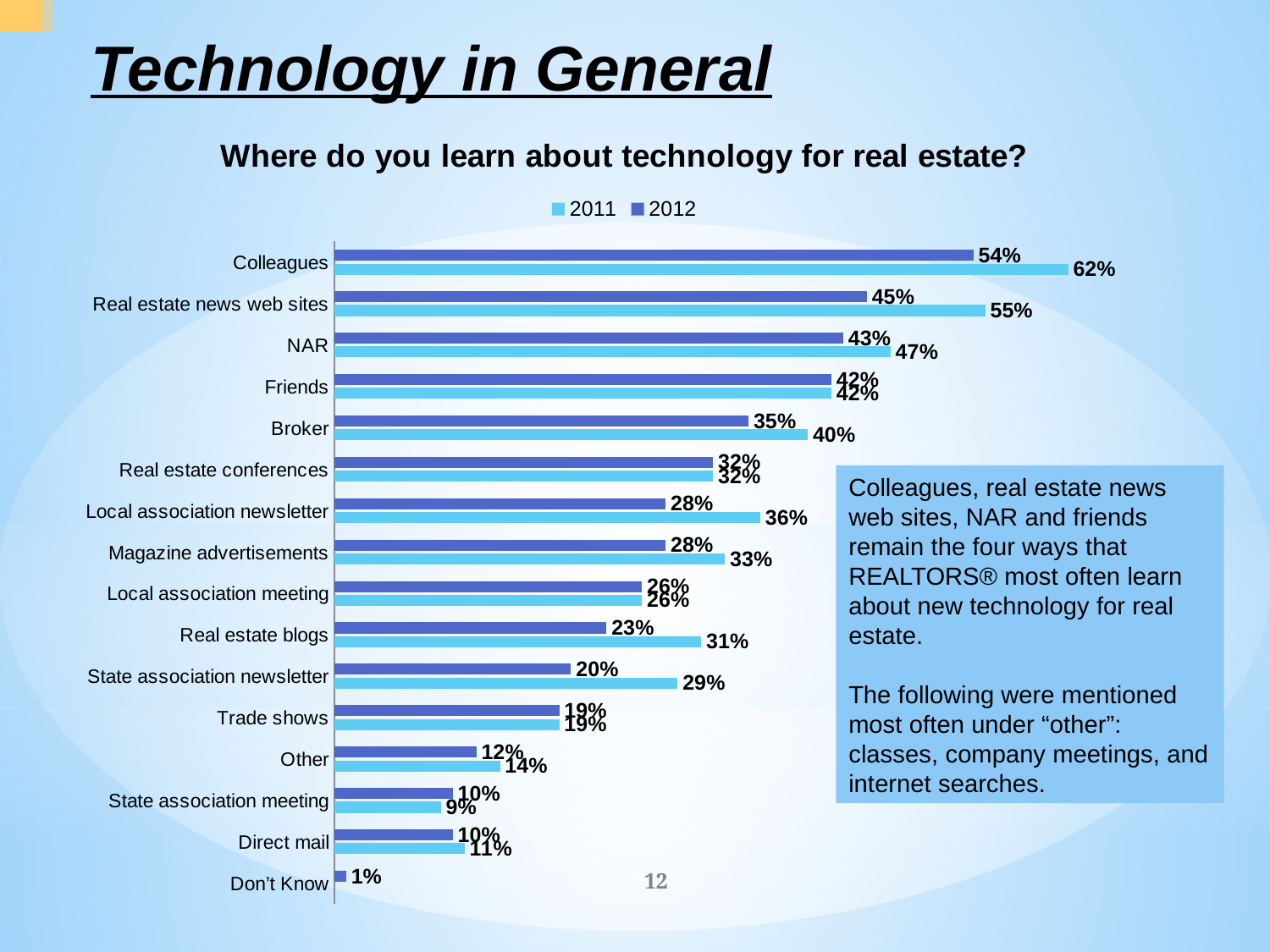
What kind of chart is shown on the slide? Bar chart What is the 2011 value for State association newsletter? 29% What is the 2012 value for Real estate news web sites? 45% Which category has the highest 2012 value? Colleagues Which is larger for Broker, the 2011 value or the 2012 value? 2011 How many series does the legend list? 2 What is the difference between the 2011 and 2012 values for Colleagues? 8% How many categories are shown on the chart? 16 What is the title of the chart? Where do you learn about technology for real estate? What is the 2011 value for Colleagues? 62% What is the 2012 value for Real estate blogs? 23% Which category has the lowest 2011 value? State association meeting